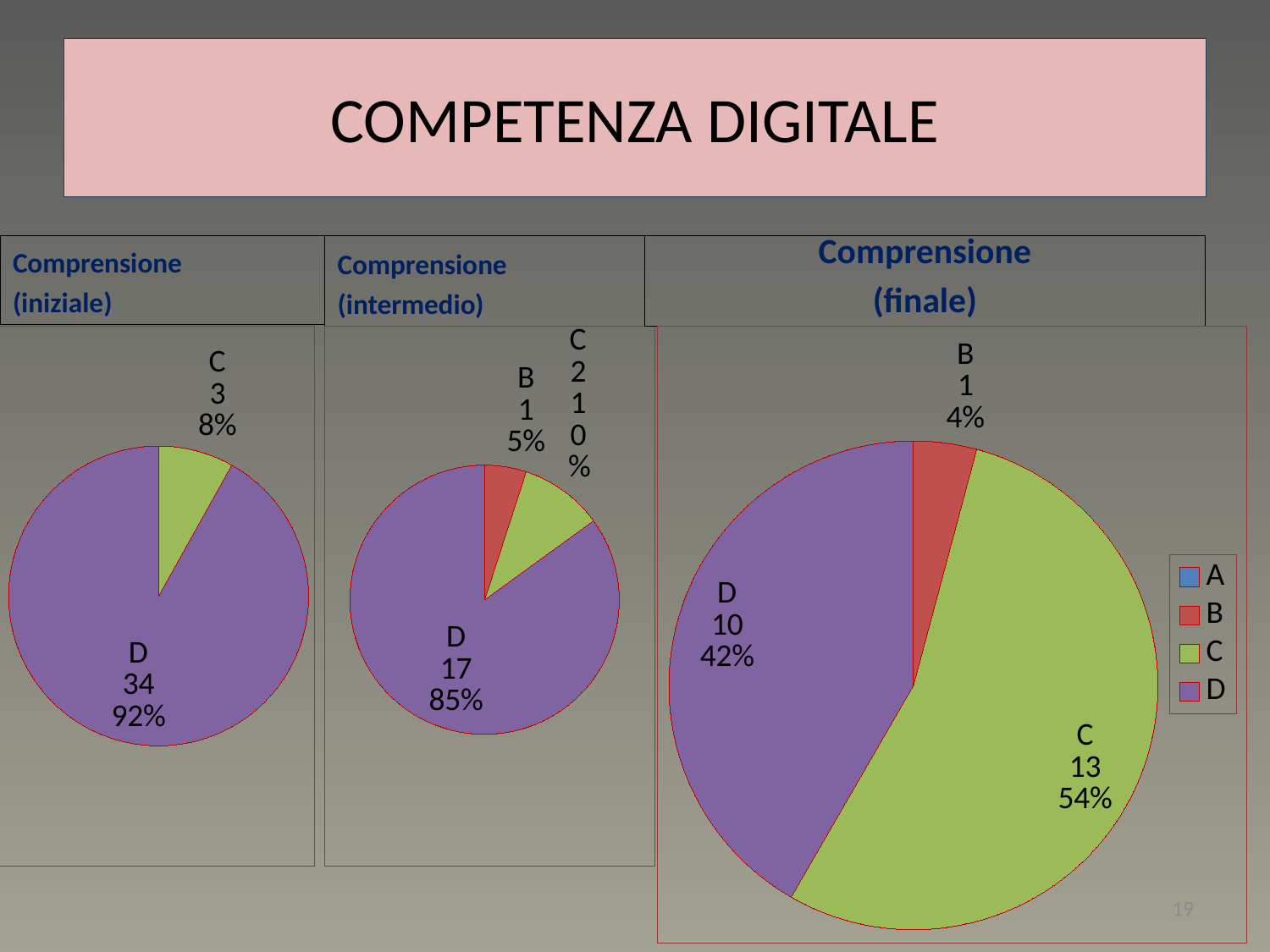
In the Comprensione (finale) chart, what value is shown for category C? 13 In the Comprensione (finale) chart, what percentage share does category D have? 42% In the Comprensione (intermedio) chart, which category has the smallest slice? B How many entries does the legend next to the Comprensione (finale) chart list? 4 In the Comprensione (finale) chart, which category has the largest slice? C How many slices does the Comprensione (intermedio) pie chart have? 3 In the Comprensione (iniziale) chart, what percentage share does category C have? 8% In the Comprensione (iniziale) chart, which is larger, the value for C or the value for D? D In the Comprensione (finale) chart, what is the difference between the values for C and D? 3 In the Comprensione (intermedio) chart, what value is shown for category D? 17 In the Comprensione (intermedio) chart, what percentage share does category B have? 5% In the Comprensione (iniziale) chart, what value is shown for category D? 34